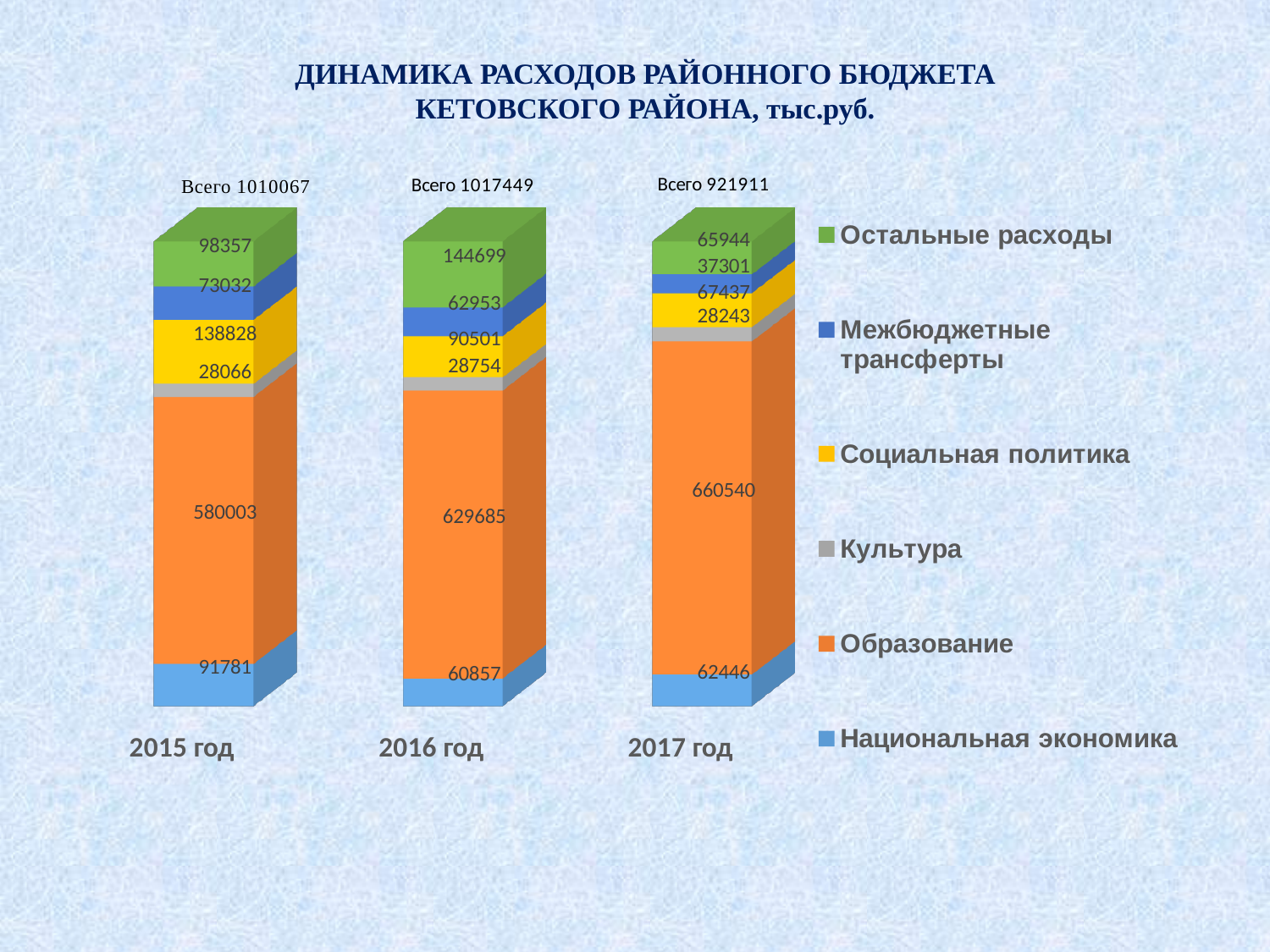
Which is larger: Социальная политика in 2016 or Межбюджетные трансферты in 2016? Социальная политика in 2016 What is the difference between the Образование values for 2017 and 2015? 80537 In which year is the value for Остальные расходы the highest? 2016 What type of chart is shown on the slide? Stacked bar chart What is the total of the 2017 bar, as printed above it? 921911 What is the value for Межбюджетные трансферты in 2017? 37301 How many series does the legend list? 6 In which year is the value for Национальная экономика the lowest? 2016 How many years (bars) are shown in the chart? 3 What is the value for Образование in 2016? 629685 Does the value for Образование rise or fall from 2015 to 2017? Rises What is the value for Социальная политика in 2015? 138828